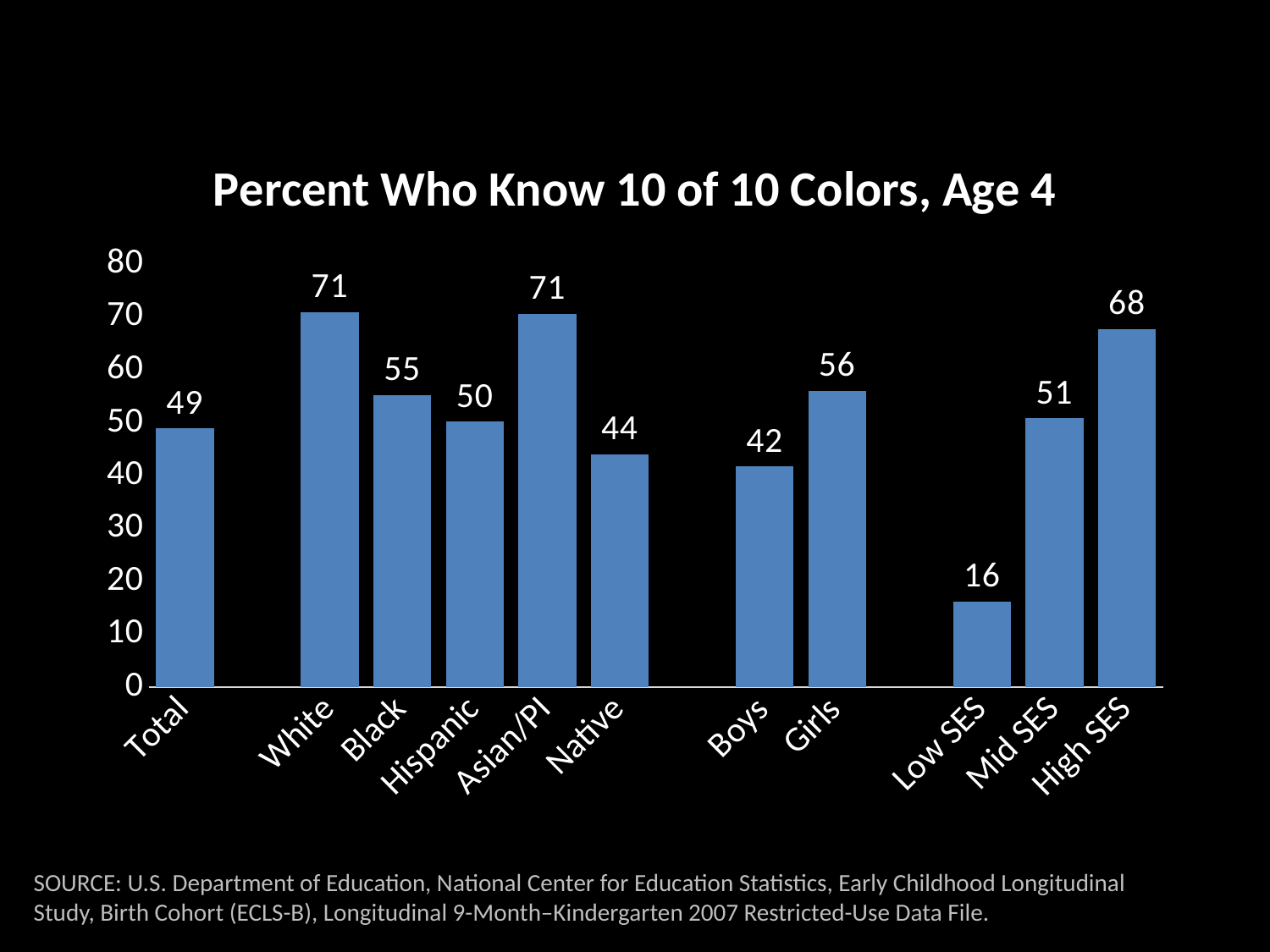
What is the difference between the values for Girls and Boys? 14 What kind of chart is shown on the slide? Bar chart Which is larger, the value for Black or the value for Hispanic? Black What is the difference between the values for High SES and Low SES? 52 What is the title of the chart? Percent Who Know 10 of 10 Colors, Age 4 What is the value for Girls? 56 What is the value for Low SES? 16 Which category has the lowest value? Low SES Which is larger, the value for Mid SES or the value for High SES? High SES How many categories are shown on the chart? 11 What is the value for Total? 49 What is the value for Native? 44